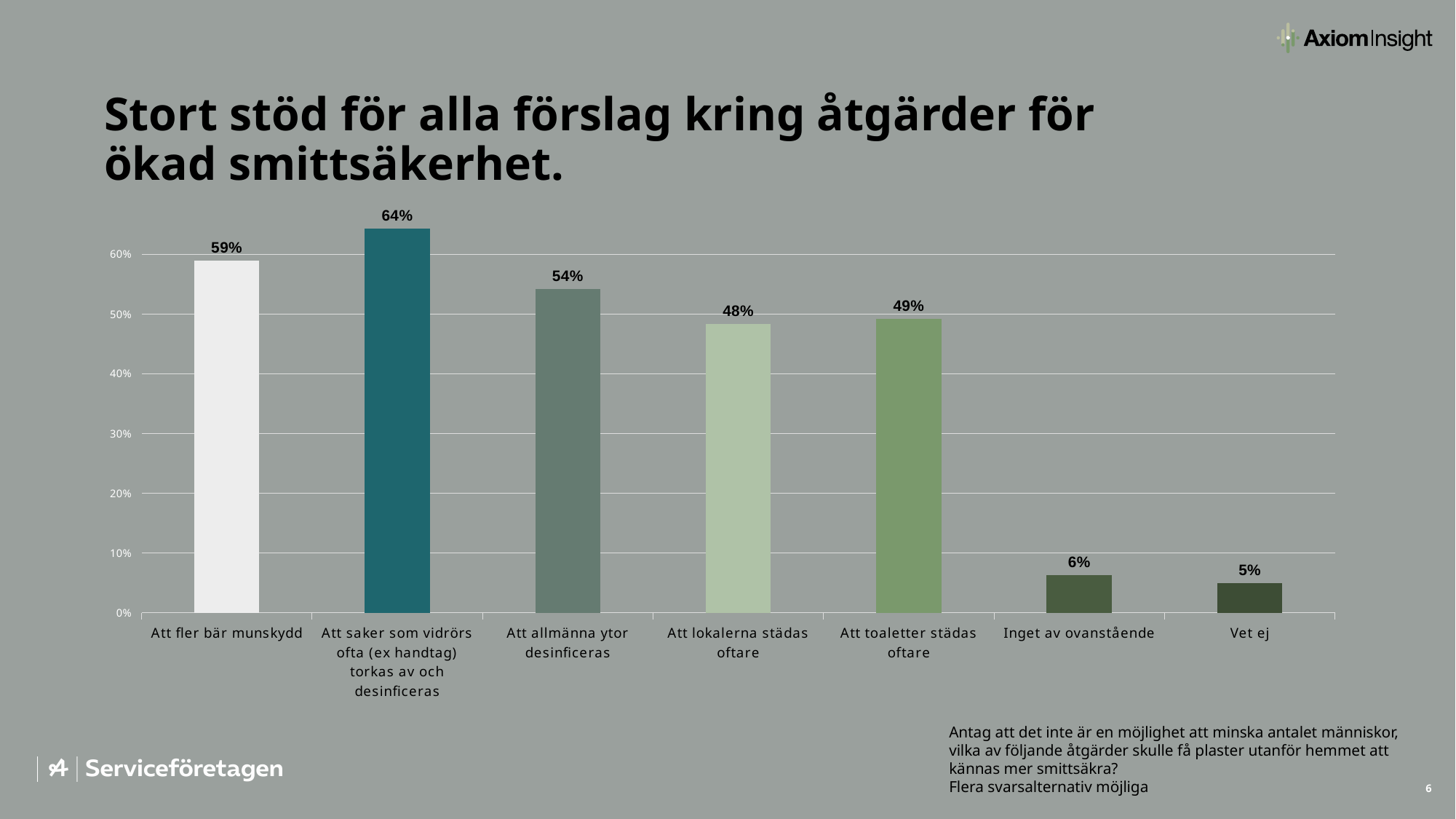
Which category has the lowest value? Vet ej What is the difference between the values for "Att toaletter städas oftare" and "Att lokalerna städas oftare"? 1% What kind of chart is shown on the slide? bar chart What is the value for "Inget av ovanstående"? 6% Which category has the highest value? Att saker som vidrörs ofta (ex handtag) torkas av och desinficeras How many categories are shown on the x axis? 7 What is the value for "Att fler bär munskydd"? 59% Which is larger, the value for "Att allmänna ytor desinficeras" or the value for "Att lokalerna städas oftare"? Att allmänna ytor desinficeras What is the value for "Att allmänna ytor desinficeras"? 54% What is the difference between the values for "Att saker som vidrörs ofta (ex handtag) torkas av och desinficeras" and "Att fler bär munskydd"? 5% Is the value for "Att toaletter städas oftare" greater or less than 40%? greater What is the value for "Vet ej"? 5%